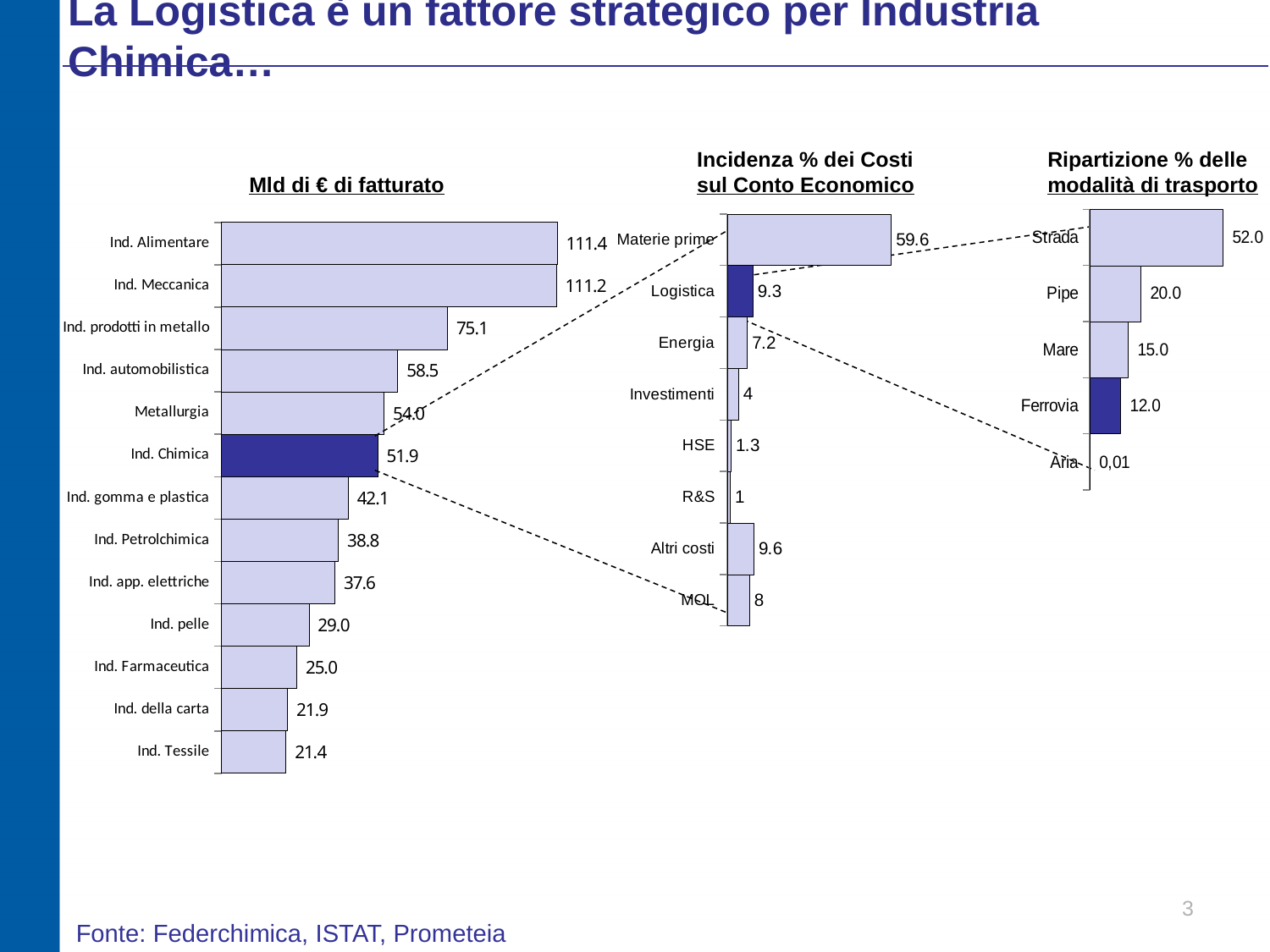
In the 'Incidenza % dei Costi sul Conto Economico' chart, what is the value for Logistica? 9.3 In the 'Incidenza % dei Costi sul Conto Economico' chart, which is larger, Energia or Altri costi? Altri costi In the 'Mld di € di fatturato' chart, what is the value for Ind. Chimica? 51.9 In the 'Mld di € di fatturato' chart, which category has the lowest value? Ind. Tessile In the 'Ripartizione % delle modalità di trasporto' chart, what is the value for Ferrovia? 12.0 In the 'Mld di € di fatturato' chart, which category has the highest value? Ind. Alimentare In the 'Mld di € di fatturato' chart, how many categories are shown? 13 In the 'Ripartizione % delle modalità di trasporto' chart, what is the difference between Strada and Pipe? 32.0 What kind of chart is the 'Ripartizione % delle modalità di trasporto' chart? Bar chart In the 'Mld di € di fatturato' chart, what is the difference between Ind. prodotti in metallo and Ind. automobilistica? 16.6 In the 'Incidenza % dei Costi sul Conto Economico' chart, how many categories are shown? 8 In the 'Incidenza % dei Costi sul Conto Economico' chart, which category has the highest value? Materie prime